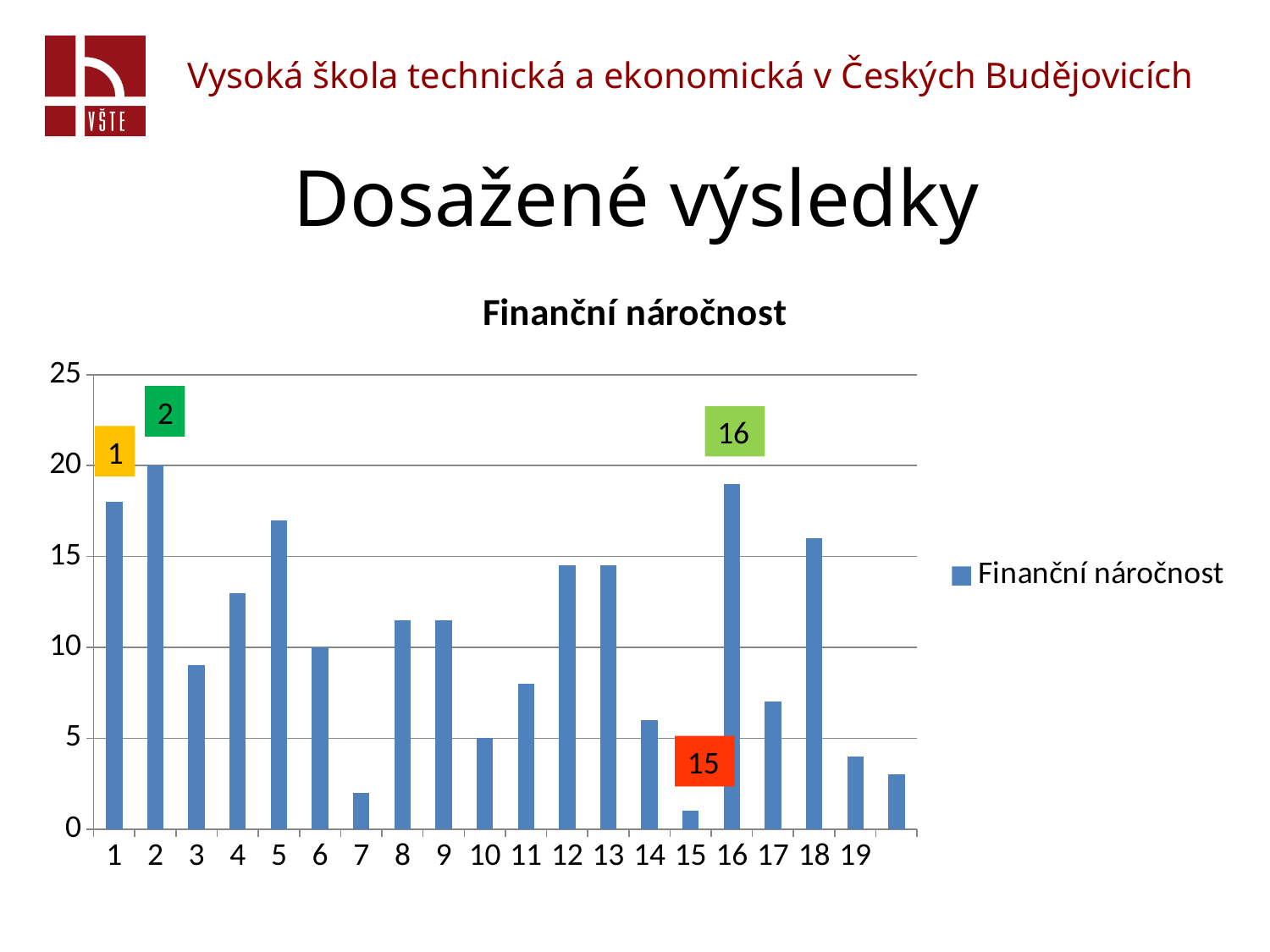
Which category has the highest value? 2 Which category has the lowest value? 15 What is the value for category 10? 5 Which is larger, the value for category 16 or the value for category 17? 16 How many series does the legend list? 1 What is the title of the chart? Finanční náročnost Is the value for category 1 greater or less than 15? greater Is the value for category 7 greater or less than 5? less What is the value for category 2? 20 Which category numbers are highlighted with coloured boxes on the chart? 1, 2, 15, 16 What type of chart is shown on the slide? bar chart What is the value for category 6? 10